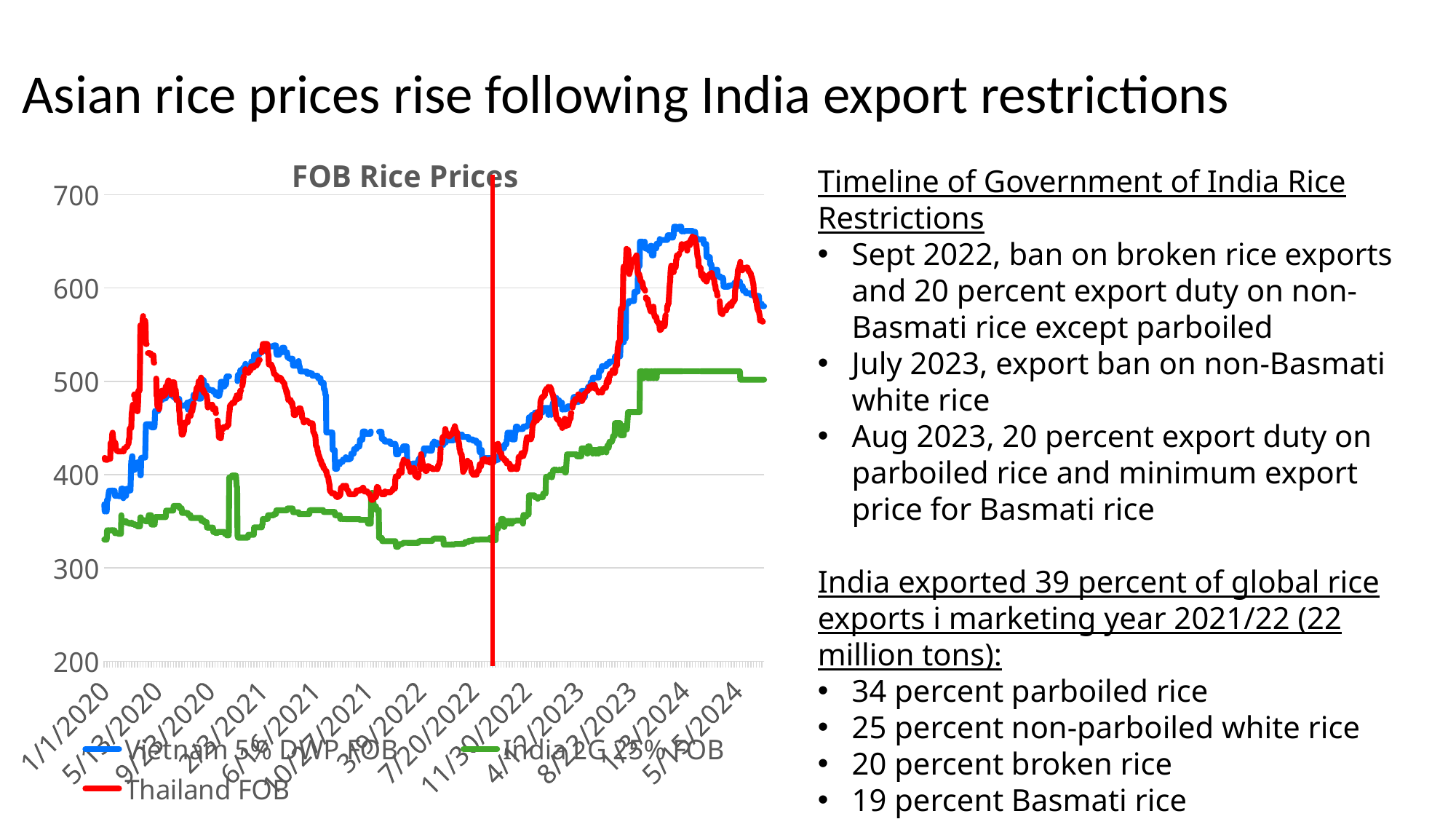
Which colour is used for the Thailand FOB series in the chart? Red Is the value for India LG 25% FOB in mid-2022 greater or less than 400? less How many series does the legend of the FOB Rice Prices chart list? 3 Which series has the lowest value at the end of the chart in 2024? India LG 25% FOB Is the peak value for Vietnam 5% DWP FOB in early 2024 greater or less than 600? greater Does the India LG 25% FOB series rise or fall between mid-2022 and early 2024? Rise What kind of chart is shown on the slide? Line chart Is the value for Thailand FOB at the start of the chart (1/1/2020) greater or less than 400? greater What is the title of the chart on the slide? FOB Rice Prices Which series has the lowest value at the start of the chart on 1/1/2020? India LG 25% FOB